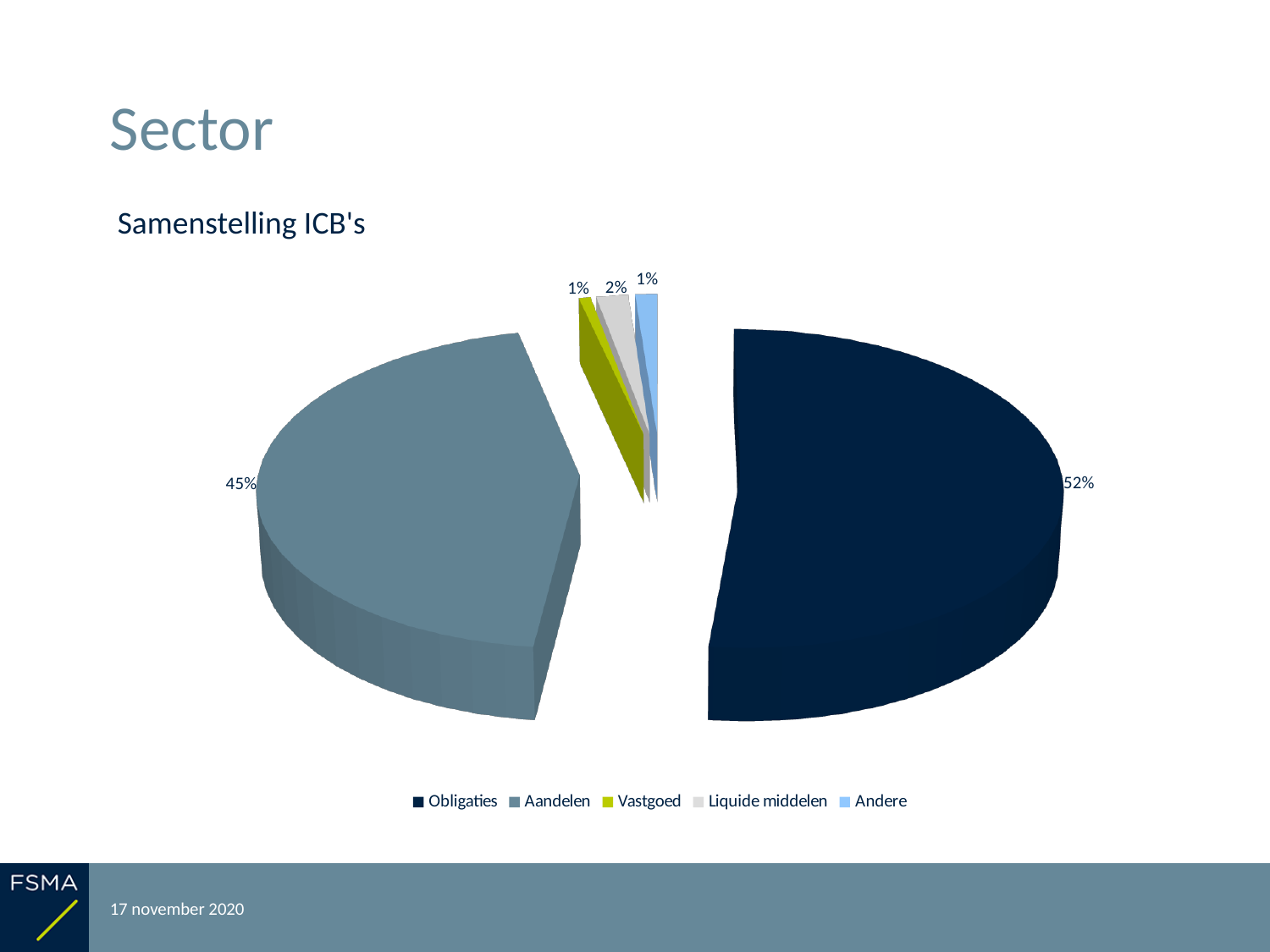
What is the difference in percentage points between the Obligaties share and the Aandelen share? 7 What is the title of the chart? Samenstelling ICB's What is the combined share of Obligaties and Aandelen? 97% Which category has the largest share of the pie? Obligaties Which is larger, the share for Liquide middelen or the share for Andere? Liquide middelen What share of the pie does Vastgoed have? 1% What share of the pie does Aandelen have? 45% Which is larger, the share for Obligaties or the share for Aandelen? Obligaties What share of the pie does Liquide middelen have? 2% What share of the pie does Obligaties have? 52% How many categories does the legend list? 5 What kind of chart is shown on the slide? pie chart